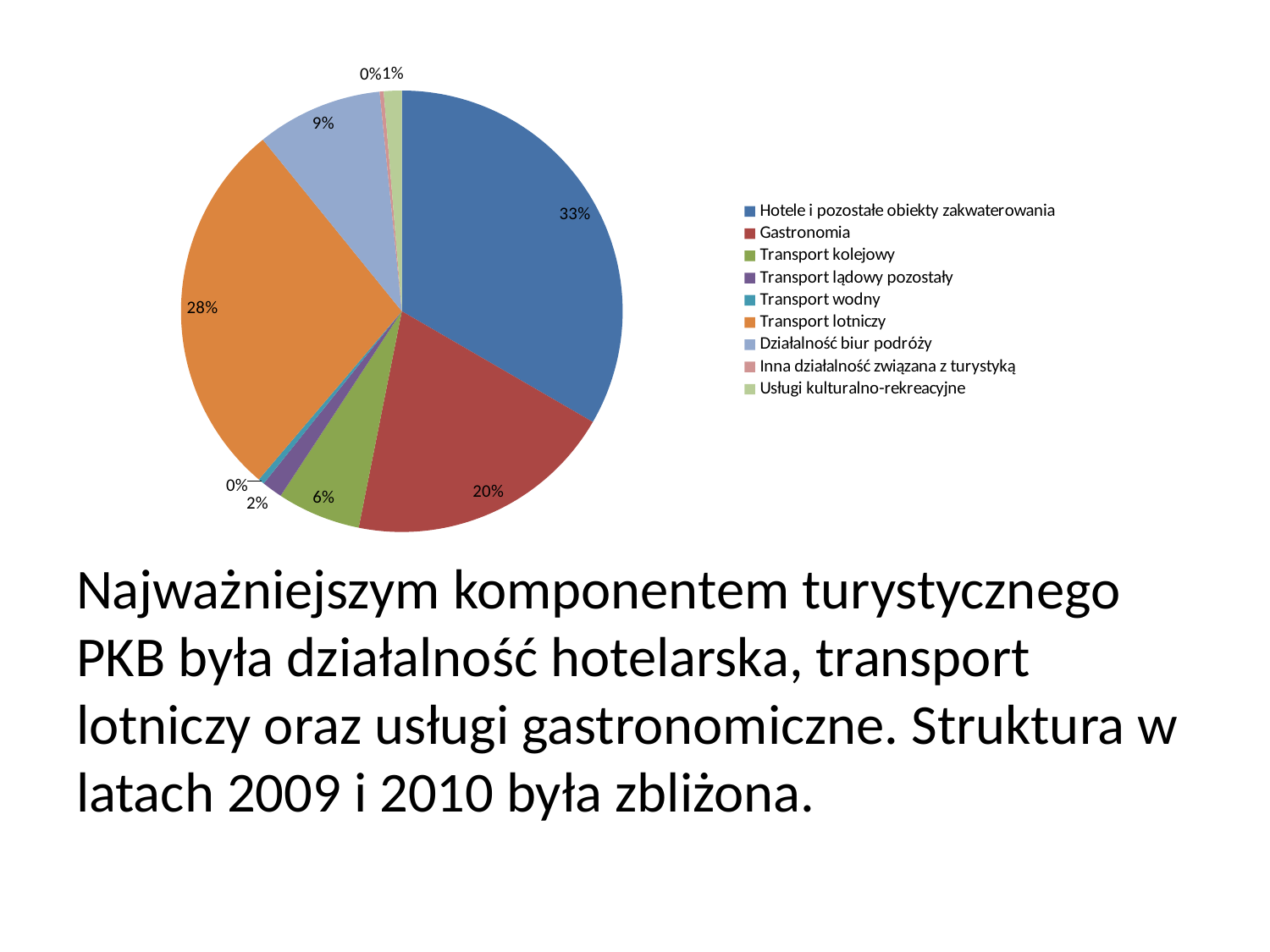
Which has a larger share, "Gastronomia" or "Działalność biur podróży"? Gastronomia What type of chart is shown on the slide? pie chart Which category has the largest slice of the pie? Hotele i pozostałe obiekty zakwaterowania What share of the pie does "Transport lotniczy" have? 28% What share of the pie does "Transport lądowy pozostały" have? 2% What is the difference in percentage points between the shares of "Hotele i pozostałe obiekty zakwaterowania" and "Transport lotniczy"? 5 percentage points What share of the pie does "Hotele i pozostałe obiekty zakwaterowania" have? 33% What colour is the slice for "Transport lotniczy"? orange How many categories does the legend list? 9